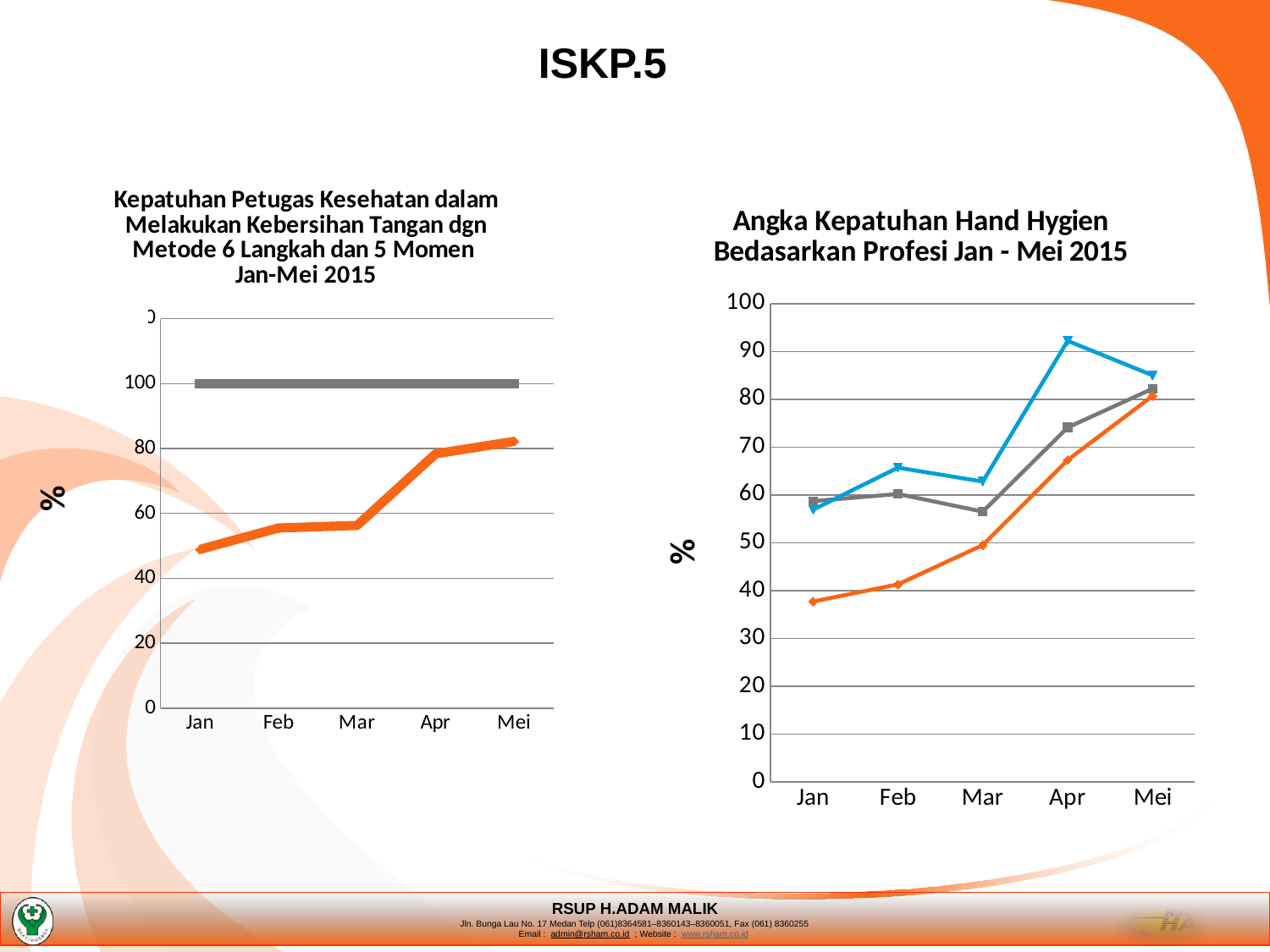
In the right chart, is the blue line's value for Apr greater or less than 80? greater In the left chart, is the orange line's value for Jan greater or less than 60? less In the right chart, in which month is the orange line at its lowest value? Jan In the right chart, which line is higher in Apr, the blue line or the orange line? The blue line In the left chart, at what value does the flat gray line sit? 100 What type of chart is the left chart titled 'Kepatuhan Petugas Kesehatan dalam Melakukan Kebersihan Tangan dgn Metode 6 Langkah dan 5 Momen Jan-Mei 2015'? Line chart In the left chart, does the orange line generally rise or fall from Jan to Mei? Rise In the right chart, in which month does the blue line reach its highest value? Apr What type of chart is the right chart titled 'Angka Kepatuhan Hand Hygien Bedasarkan Profesi Jan - Mei 2015'? Line chart In the right chart, how many lines are plotted? 3 In the left chart, is the orange line's value for Apr greater or less than 60? greater In the left chart, how many months are shown on the x axis? 5